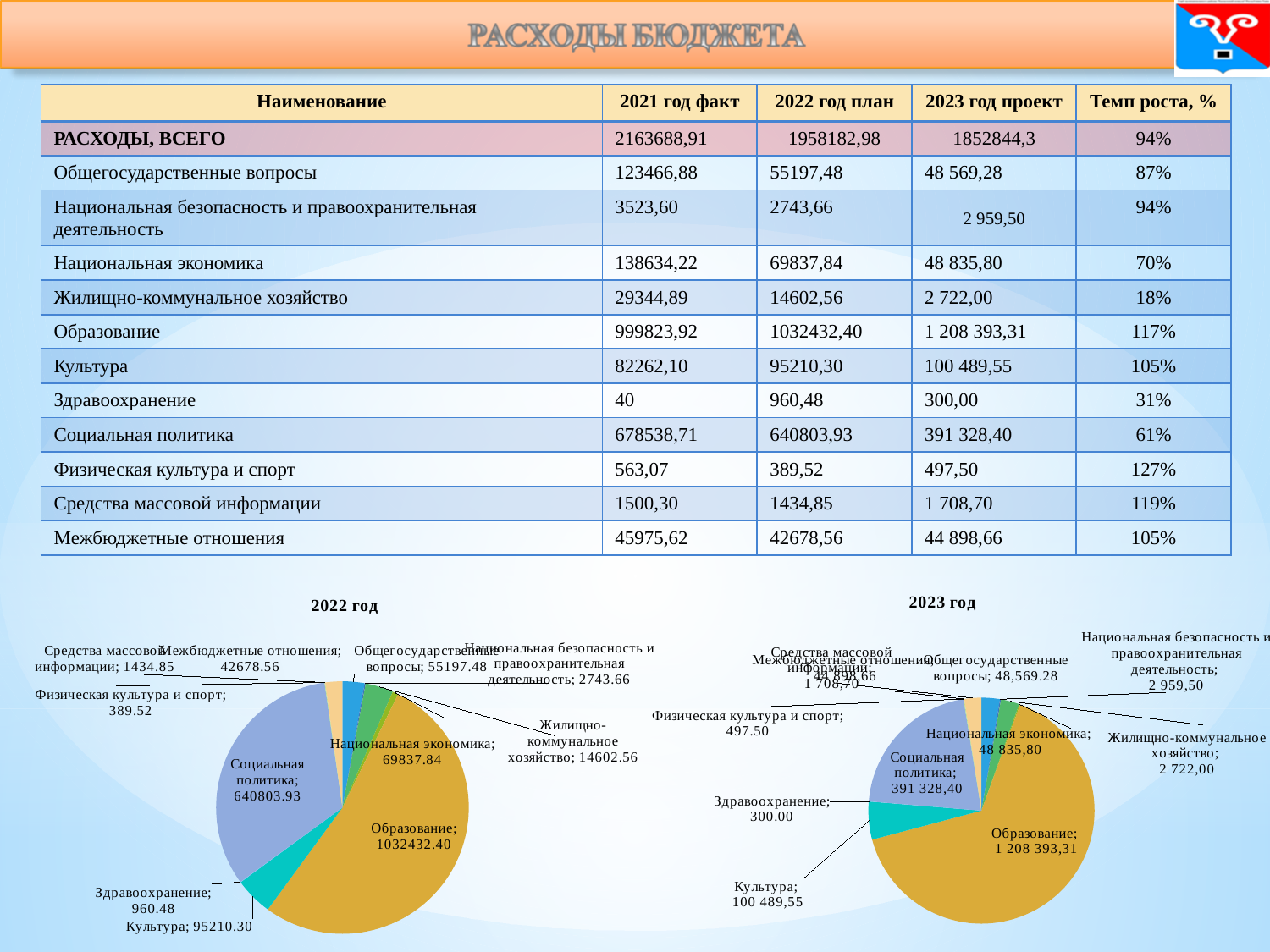
In the "2023 год" chart, which is larger: Социальная политика or Образование? Образование In the "2022 год" chart, what is the value for Социальная политика? 640803.93 In the "2022 год" chart, which category has the smallest value? Физическая культура и спорт In the "2022 год" chart, what is the value for Образование? 1032432.40 In the "2022 год" chart, which category has the largest slice? Образование In the "2023 год" chart, what is the value for Образование? 1 208 393,31 What kind of chart is the "2022 год" chart? pie chart In the "2023 год" chart, what is the value for Здравоохранение? 300.00 In the "2023 год" chart, what is the value for Культура? 100 489,55 How many categories are shown in the "2022 год" pie chart? 11 In the "2023 год" chart, which category has the smallest value? Здравоохранение In the "2022 год" chart, what is the difference between Образование and Социальная политика? 391628.47